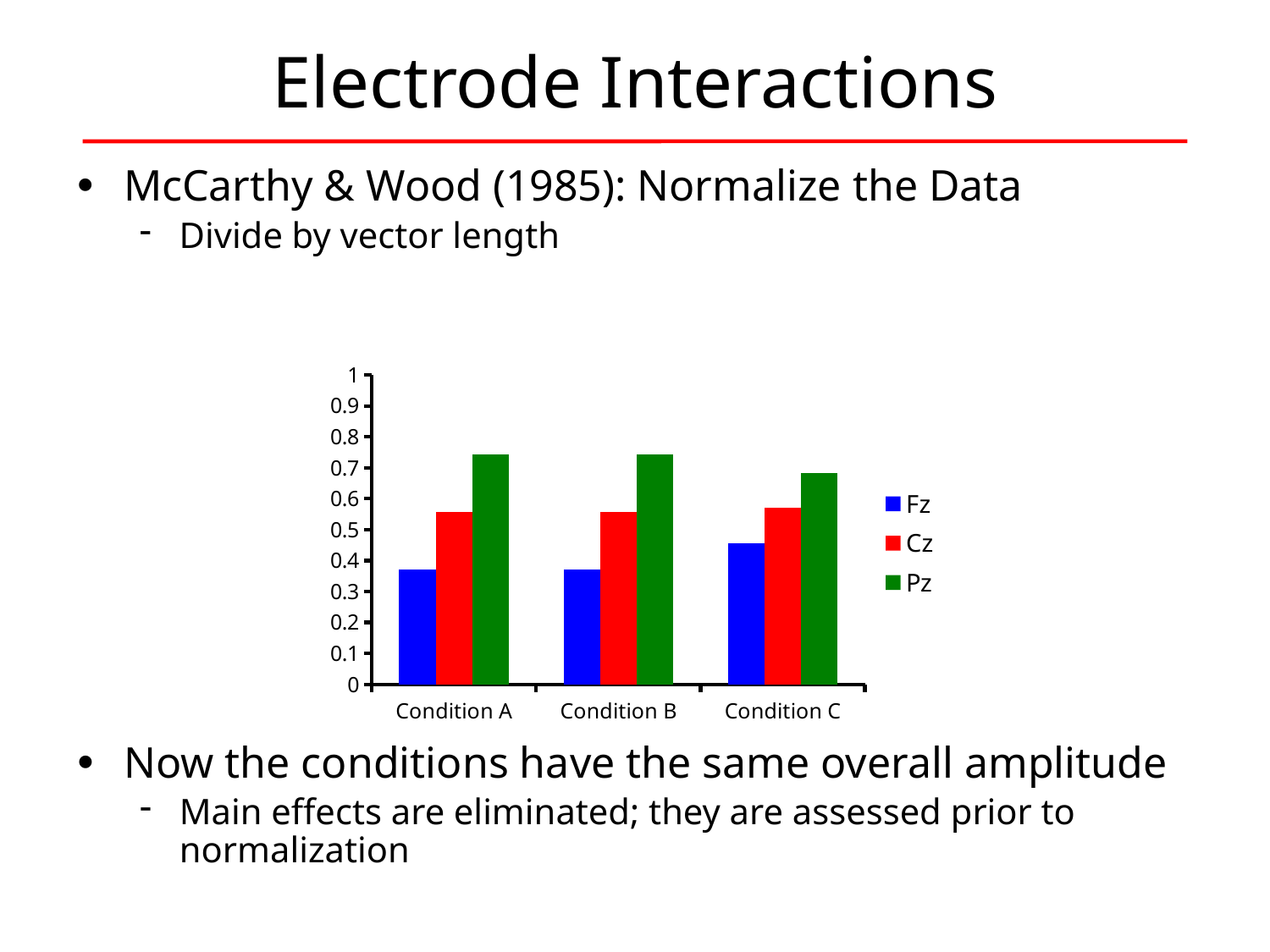
What kind of chart is shown on the slide? bar chart Which series has the highest value in Condition A? Pz Which is larger, the Pz value for Condition A or the Pz value for Condition C? Condition A Is the Pz value for Condition B greater or less than 0.6? greater Is the Fz value for Condition A greater or less than 0.5? less Which condition has the highest Fz value? Condition C Which series has the lowest value in Condition C? Fz How many series does the chart's legend list? 3 Which is larger, the Fz value for Condition C or the Fz value for Condition B? Condition C How many conditions are shown on the x axis of the chart? 3 What colour are the Pz bars in the chart? green Is the Cz value for Condition C greater or less than 0.5? greater